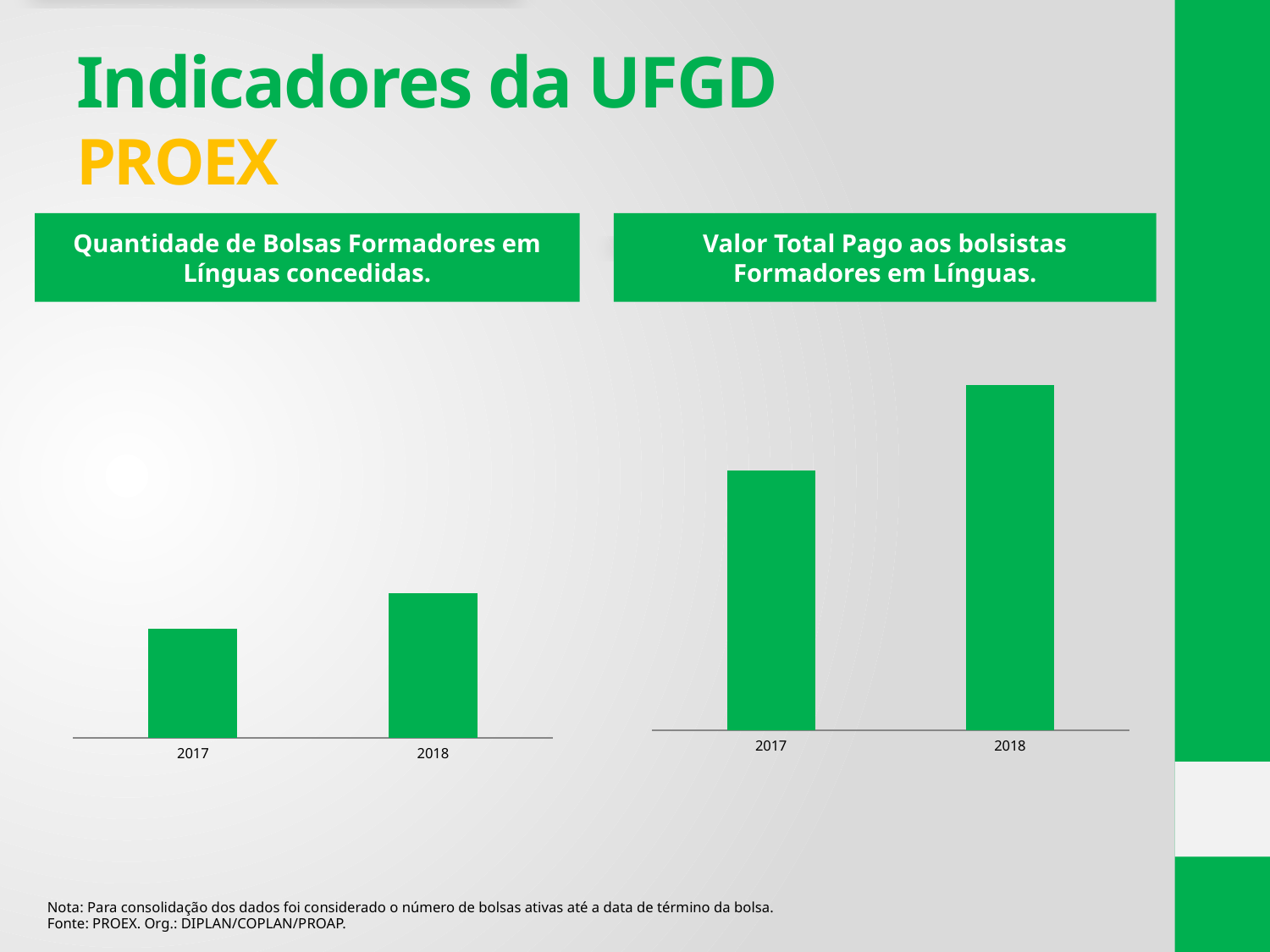
In the right chart, is the value for 2018 larger or smaller than the value for 2017? larger In the chart titled "Valor Total Pago aos bolsistas Formadores em Línguas.", which year has the lower value? 2017 What kind of chart is the right chart on the slide? bar chart How many categories are shown on the x axis of the left chart? 2 In the chart titled "Quantidade de Bolsas Formadores em Línguas concedidas.", which year has the higher value? 2018 What kind of chart is the left chart on the slide? bar chart How many bars are shown in the right chart? 2 In the chart titled "Valor Total Pago aos bolsistas Formadores em Línguas.", do the values rise or fall from 2017 to 2018? rise What is the title of the left chart on the slide? Quantidade de Bolsas Formadores em Línguas concedidas. In the chart titled "Valor Total Pago aos bolsistas Formadores em Línguas.", which year has the higher value? 2018 In the chart titled "Quantidade de Bolsas Formadores em Línguas concedidas.", which year has the lower value? 2017 In the left chart, is the value for 2017 larger or smaller than the value for 2018? smaller